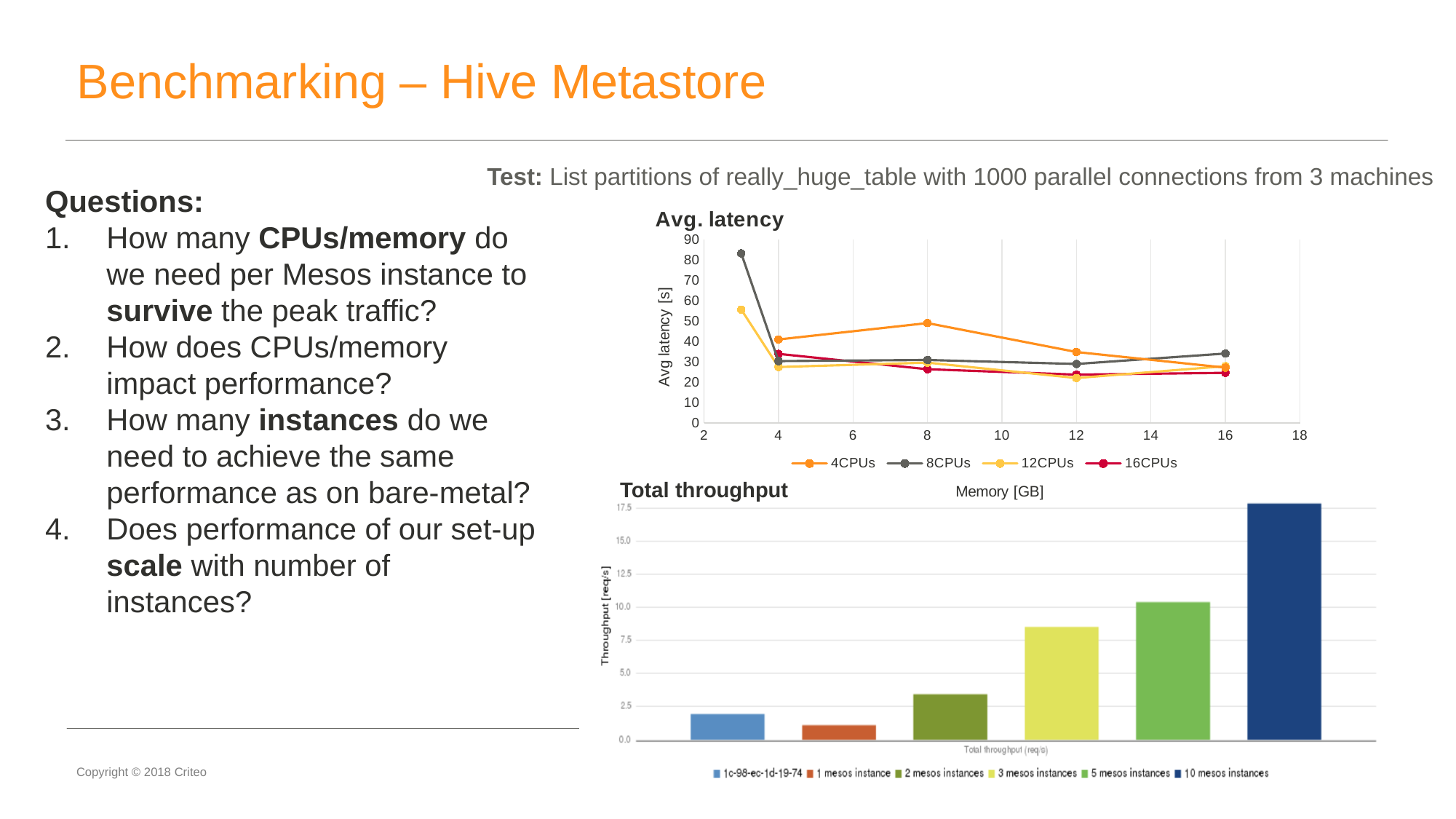
In the Total throughput chart, which category has the highest throughput? 10 mesos instances In the Avg. latency chart, does the 4CPUs series rise or fall from 8 GB to 16 GB of memory? fall What kind of chart is the Avg. latency chart? line chart How many bars are in the Total throughput chart? 6 In the Avg. latency chart, is the 12CPUs value at the lowest memory point greater or less than 50? greater What kind of chart is the Total throughput chart? bar chart In the Avg. latency chart, which series has the highest latency at 8 GB of memory? 4CPUs How many series does the legend of the Avg. latency chart list? 4 In the Avg. latency chart, is the 8CPUs value at the lowest memory point greater or less than 70? greater What is the x-axis label of the Avg. latency chart? Memory [GB] In the Total throughput chart, which category has the lowest throughput? 1 mesos instance